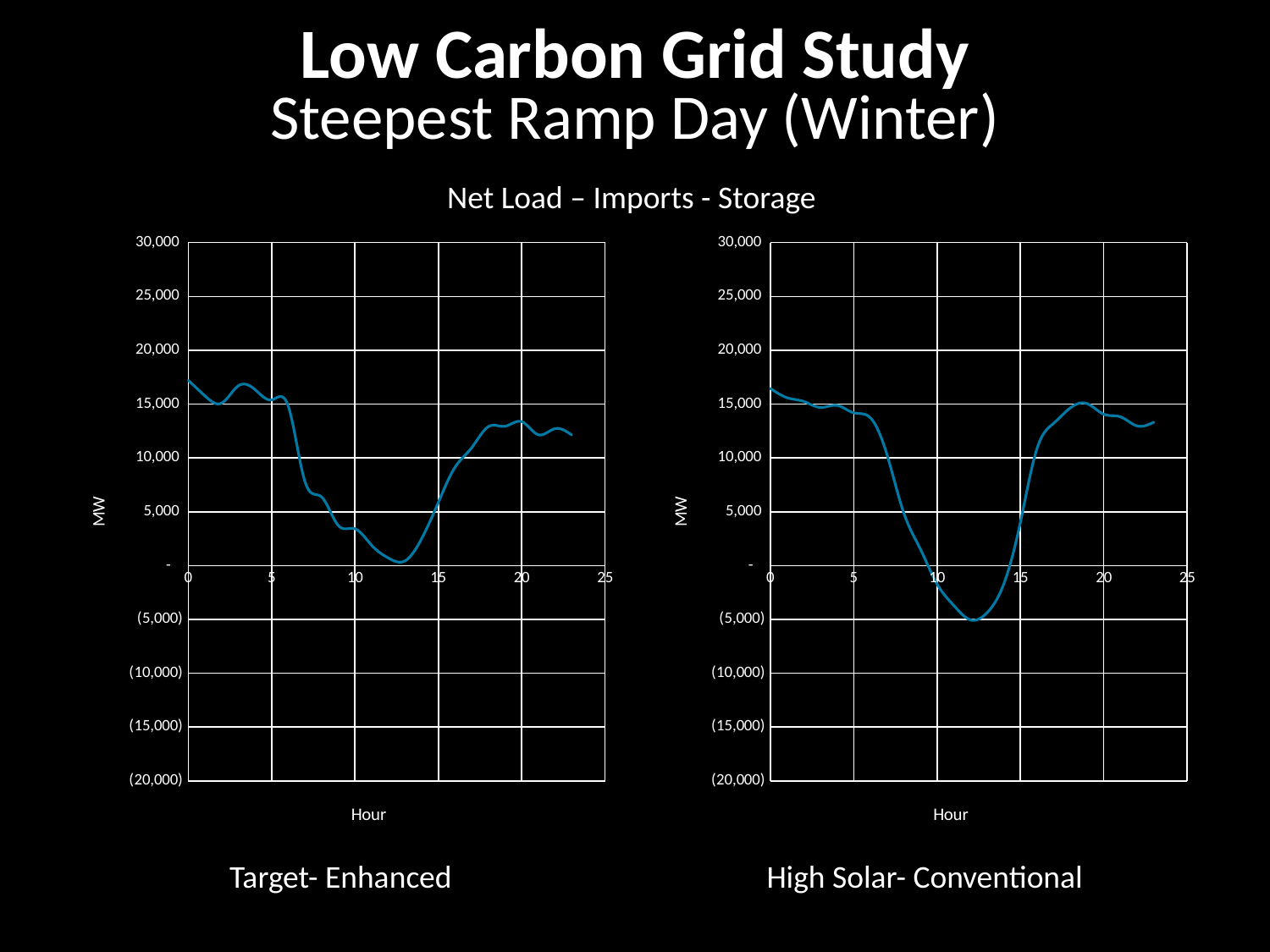
What kind of chart is the Target- Enhanced chart on the left? line chart At hour 12, which chart shows the larger value, Target- Enhanced or High Solar- Conventional? Target- Enhanced On the High Solar- Conventional chart, is the value at hour 0 greater or less than 15,000? greater On the Target- Enhanced chart, do the values rise or fall between hour 13 and hour 18? rise On the Target- Enhanced chart, is the value at hour 0 greater or less than 15,000? greater On the High Solar- Conventional chart, do the values rise or fall between hour 0 and hour 12? fall Which chart reaches the lower minimum value, Target- Enhanced or High Solar- Conventional? High Solar- Conventional On the High Solar- Conventional chart, is the value at hour 5 greater or less than 15,000? less What is the label on the vertical axis of the Target- Enhanced chart? MW What is the label on the horizontal axis of the High Solar- Conventional chart? Hour